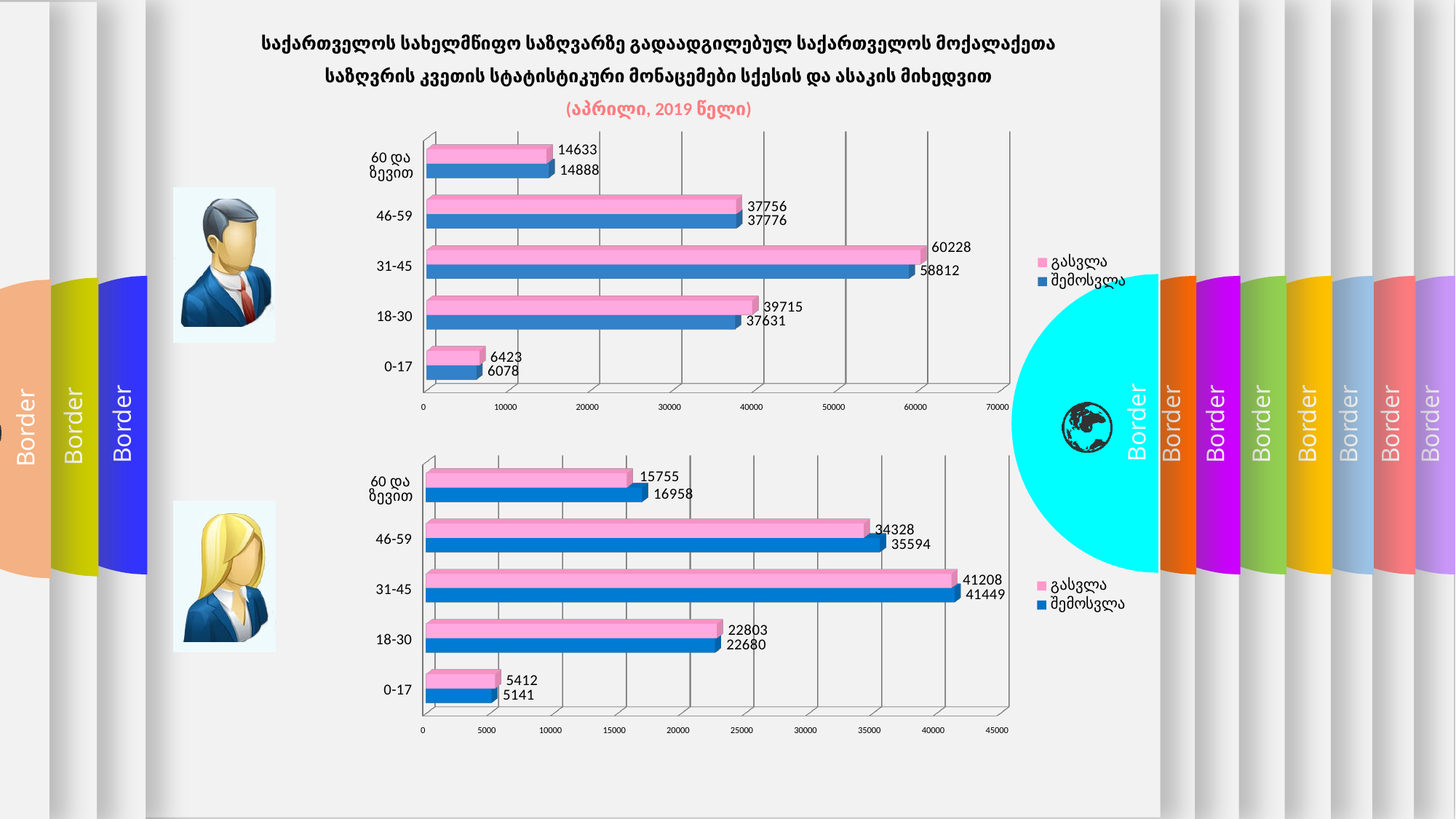
In the top chart, what is the difference between გასვლა and შემოსვლა for the 31-45 age group? 1416 In the top chart, what is the value of გასვლა for the 31-45 age group? 60228 What type of chart is the bottom chart? Bar chart In the top chart, which age group has the highest გასვლა value? 31-45 In the bottom chart, which age group has the lowest შემოსვლა value? 0-17 How many series does the legend of the top chart list? 2 In the top chart, what is the value of შემოსვლა for the 0-17 age group? 6078 How many age groups are shown in the bottom chart? 5 In the top chart, which is larger for the 18-30 age group: გასვლა or შემოსვლა? გასვლა In the bottom chart, what is the value of შემოსვლა for the 46-59 age group? 35594 In the bottom chart, what is the value of გასვლა for the 18-30 age group? 22803 In the bottom chart, what is the difference between შემოსვლა and გასვლა for the 60 და ზევით age group? 1203